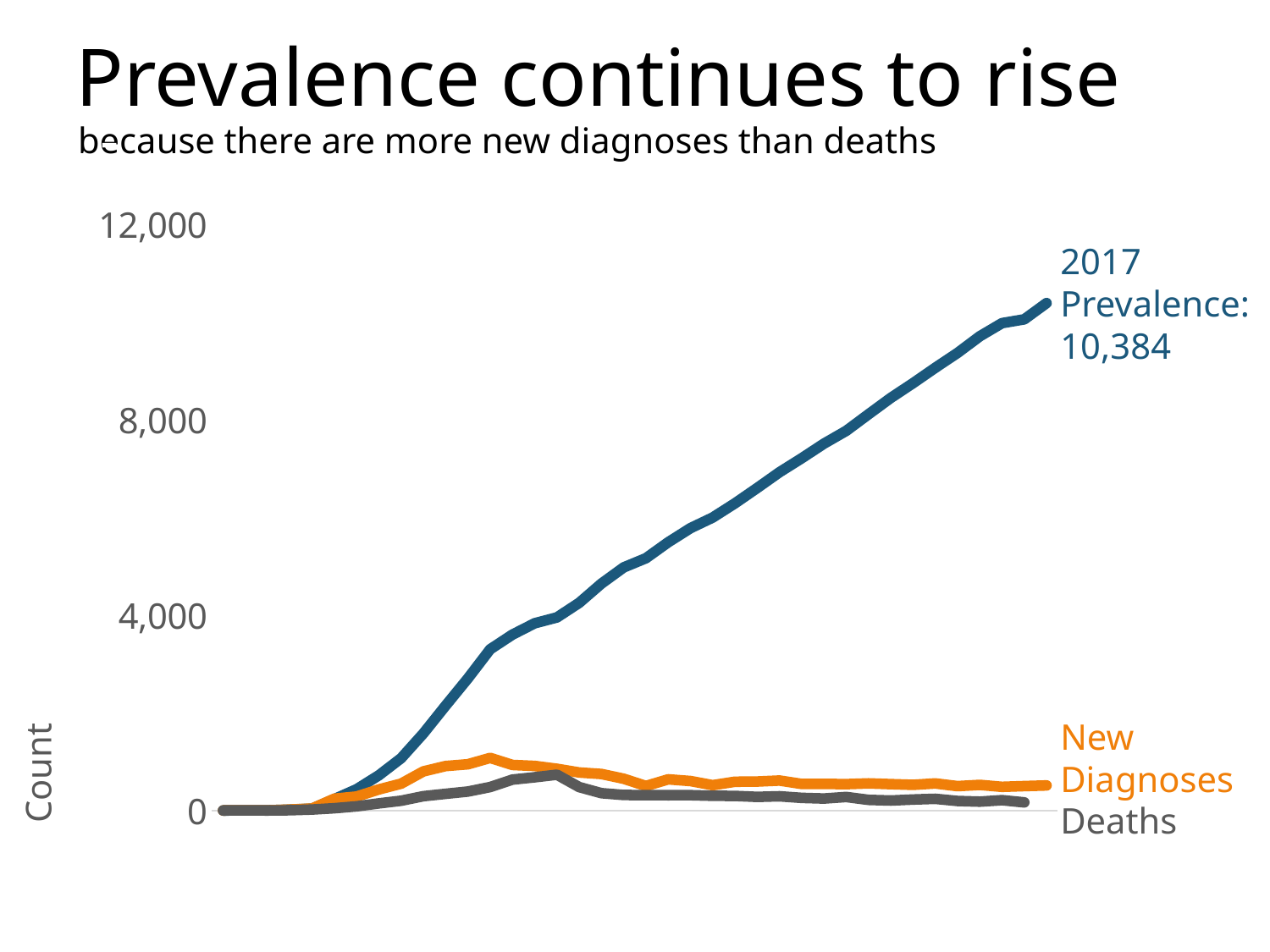
How many series are plotted on the chart? 3 Is the 2017 Prevalence value greater or less than 8,000? greater What is the 2017 prevalence value labelled on the chart? 10,384 Does the Prevalence line rise or fall along the x axis? rise Which series reaches the highest value on the chart? Prevalence Is the 2017 Prevalence value greater or less than 12,000? less What is the label on the y axis? Count Is the peak of the New Diagnoses line greater or less than 4,000? less What kind of chart is shown on the slide? line chart What is the title of the slide? Prevalence continues to rise At the right end of the chart, which is higher: New Diagnoses or Deaths? New Diagnoses